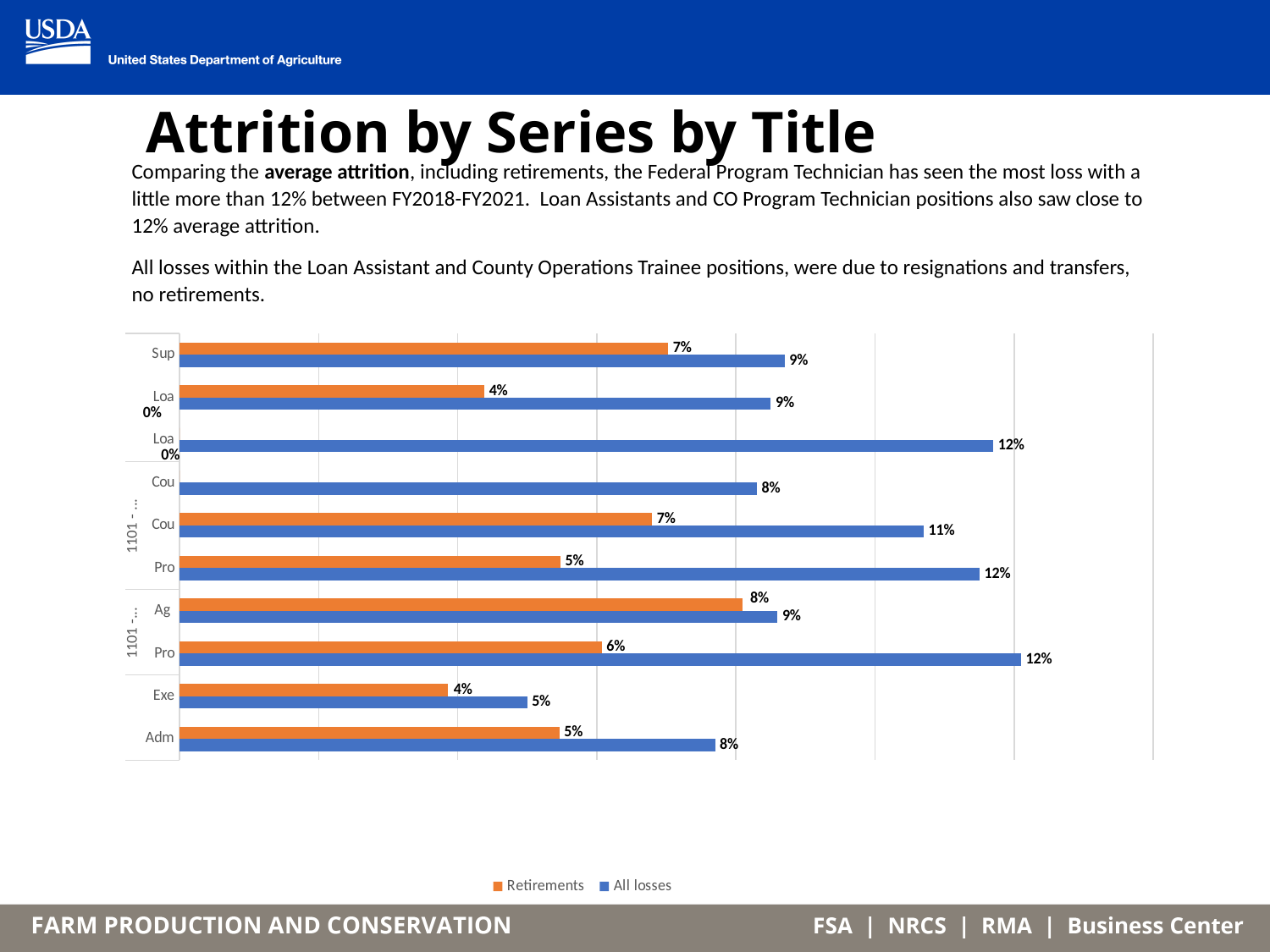
Which category has the lowest All losses value? Exe For the category labelled "Sup", what is the difference between the All losses value and the Retirements value? 2% What kind of chart is shown on the slide? bar chart What is the All losses value for the category labelled "Exe"? 5% How many categories are plotted on the chart? 10 Which has the larger All losses value, the category labelled "Adm" or the category labelled "Exe"? Adm Which category has the highest Retirements value? Ag How many series does the chart legend list? 2 What is the Retirements value for the category labelled "Adm" at the bottom of the chart? 5% Which colour represents the Retirements series in the chart? orange What is the Retirements value for the category labelled "Ag"? 8% What is the All losses value for the category labelled "Sup" at the top of the chart? 9%